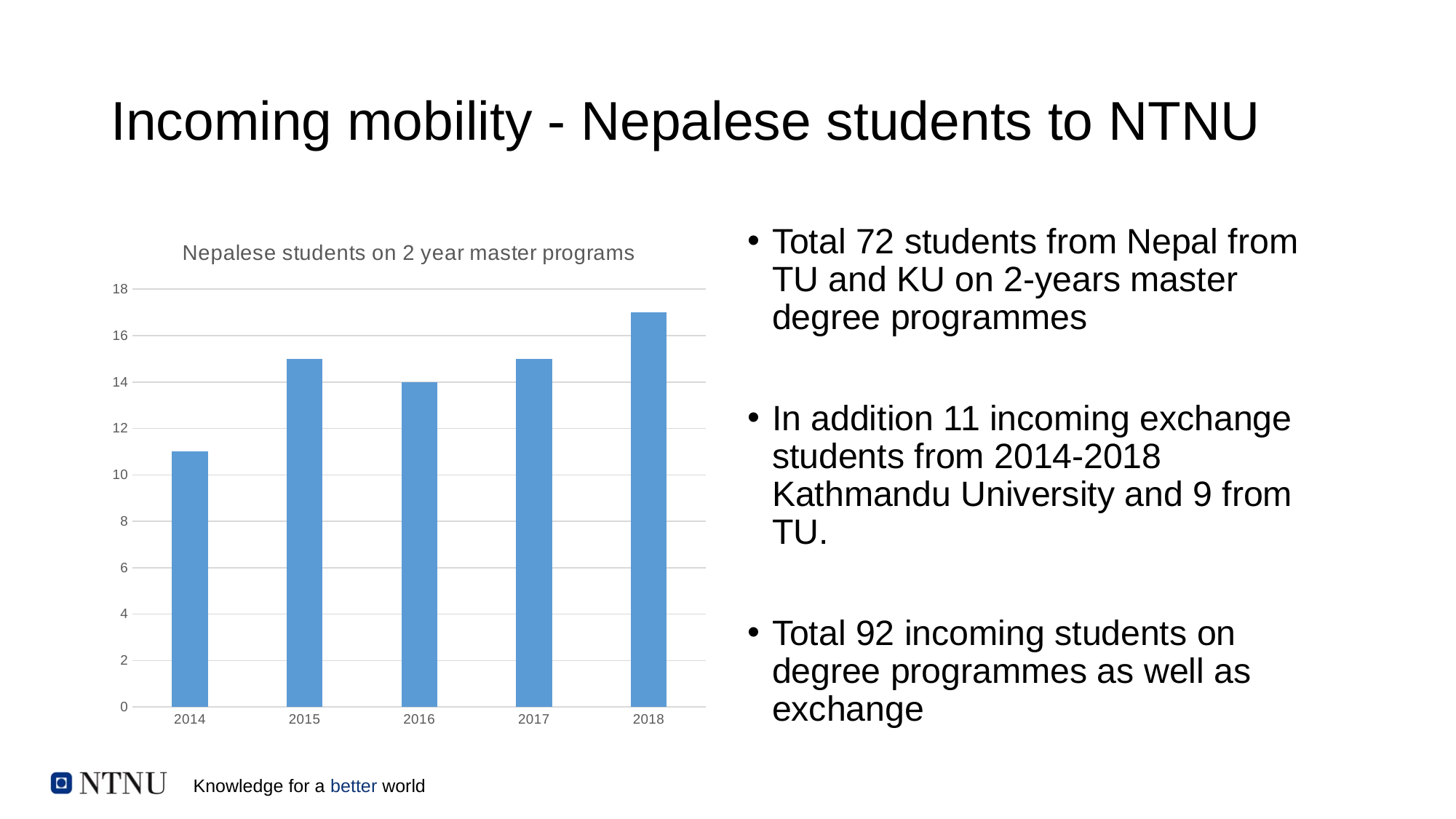
Is the value for 2018 greater or less than 16? greater What is the title of the chart? Nepalese students on 2 year master programs Overall, do the values rise or fall from 2014 to 2018? rise What is the value for 2016 in the chart? 14 Is the value for 2015 greater or less than 14? greater Is the value for 2014 greater or less than 12? less Which year has a larger value, 2014 or 2016? 2016 Which year has the highest number of Nepalese students on 2 year master programs? 2018 What type of chart is shown on the slide? bar chart Which year has the lowest number of Nepalese students on 2 year master programs? 2014 How many years are shown on the x axis of the chart? 5